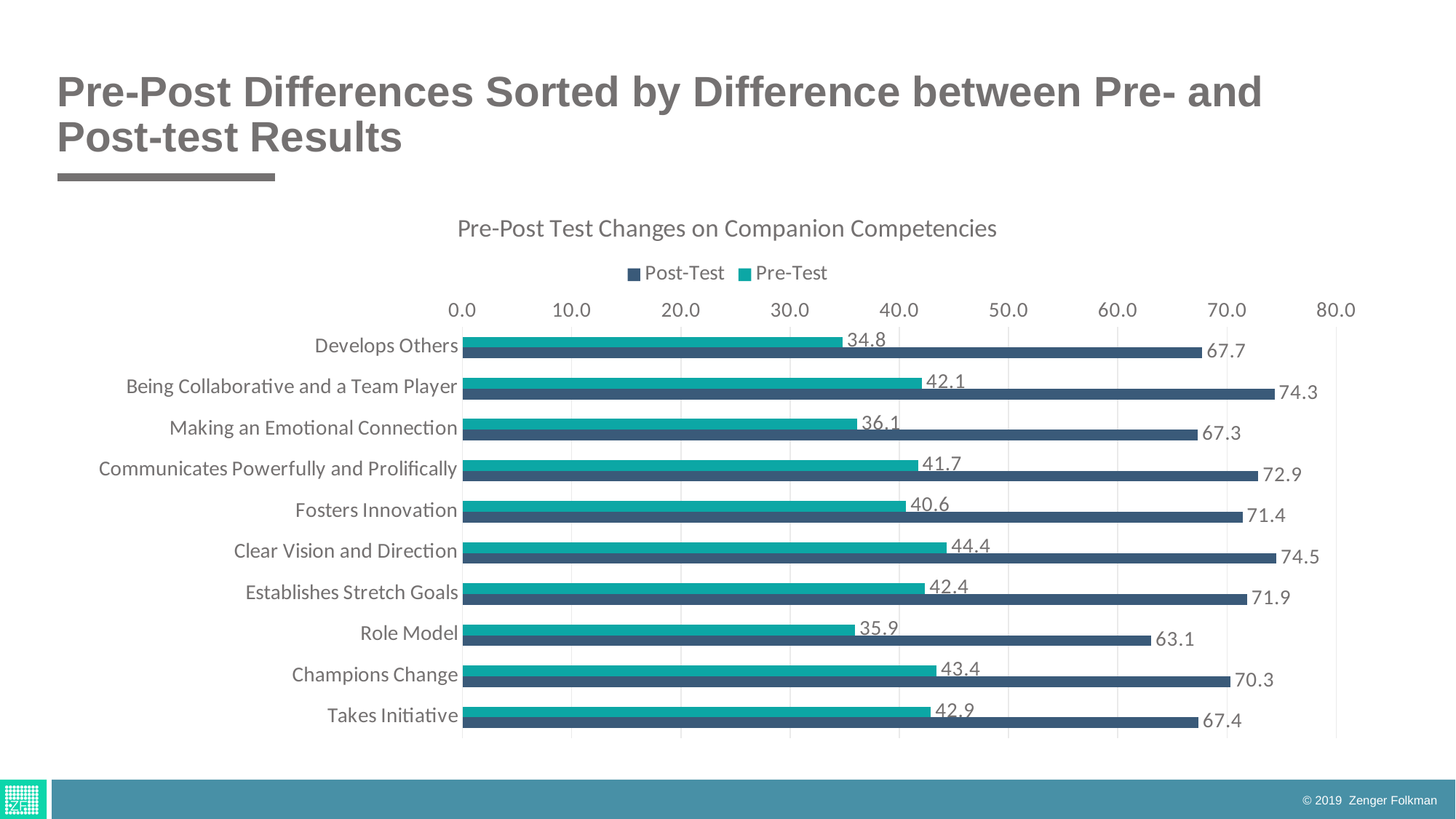
How many series does the legend list? 2 What type of chart is shown on the slide? Bar chart Is the Pre-Test value for Making an Emotional Connection greater or less than 40.0? less What is the Post-Test value for Develops Others? 67.7 What is the Post-Test value for Champions Change? 70.3 Which competency has the lowest Post-Test value? Role Model What is the Pre-Test value for Clear Vision and Direction? 44.4 What is the difference between the Post-Test and Pre-Test values for Takes Initiative? 24.5 What is the difference between the Post-Test and Pre-Test values for Develops Others? 32.9 Which is larger, the Post-Test value for Being Collaborative and a Team Player or the Post-Test value for Role Model? Being Collaborative and a Team Player How many competencies are shown on the chart? 10 What is the Pre-Test value for Role Model? 35.9